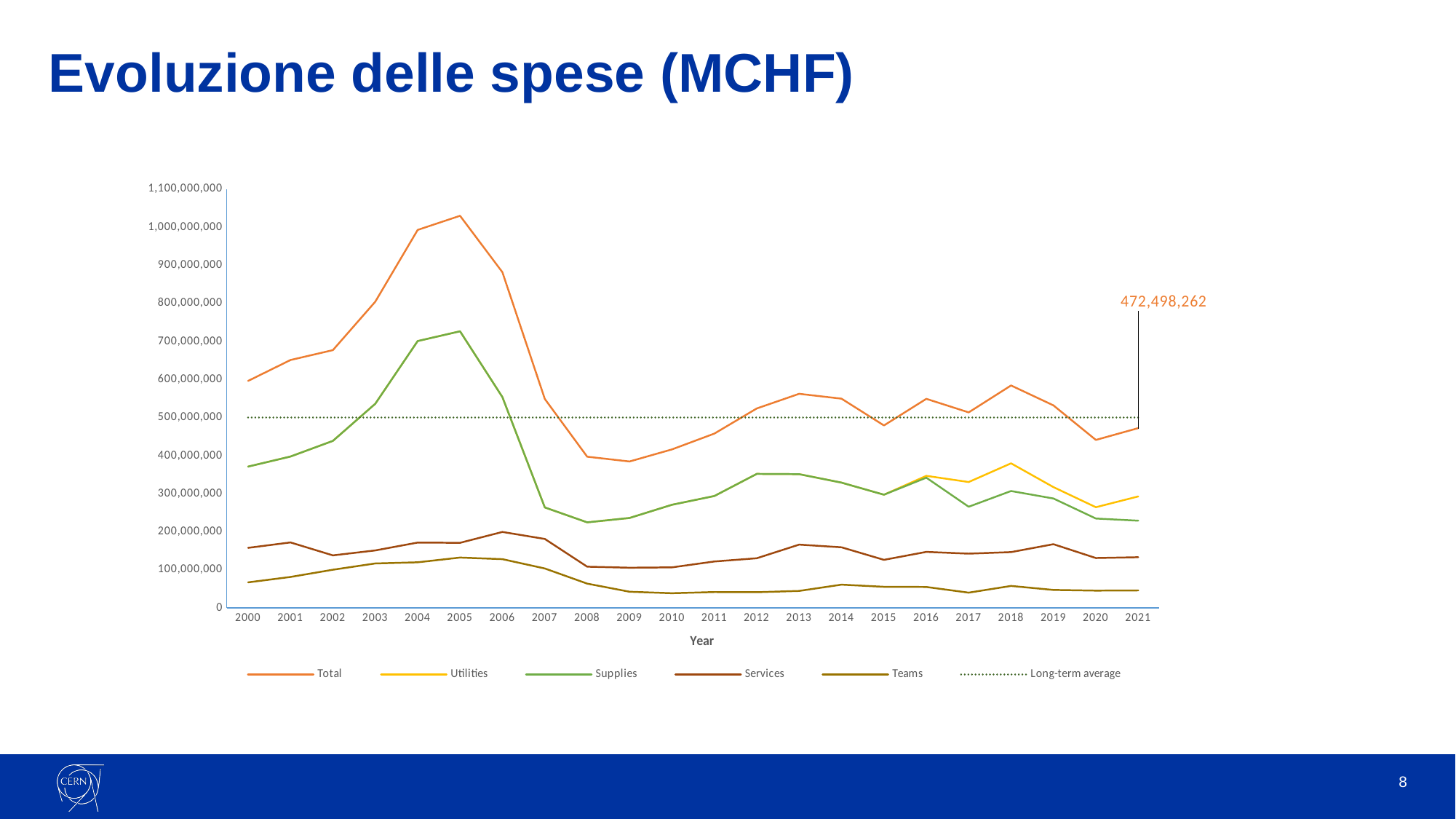
Is the value for Teams in 2010 greater or less than 100,000,000? less Is the value for Total in 2000 greater or less than 500,000,000? greater In which year does the Total series reach its highest value? 2005 What type of chart is shown on the slide? line chart Which is larger in 2005, Supplies or Services? Supplies How many series does the legend list? 6 What is the title of the x axis? Year Does the Supplies series rise or fall between 2000 and 2005? rise What is the value of the Total series in 2021? 472,498,262 In which year does the Total series reach its lowest value? 2009 Does the Total series rise or fall between 2005 and 2008? fall How many years are shown on the x axis? 22